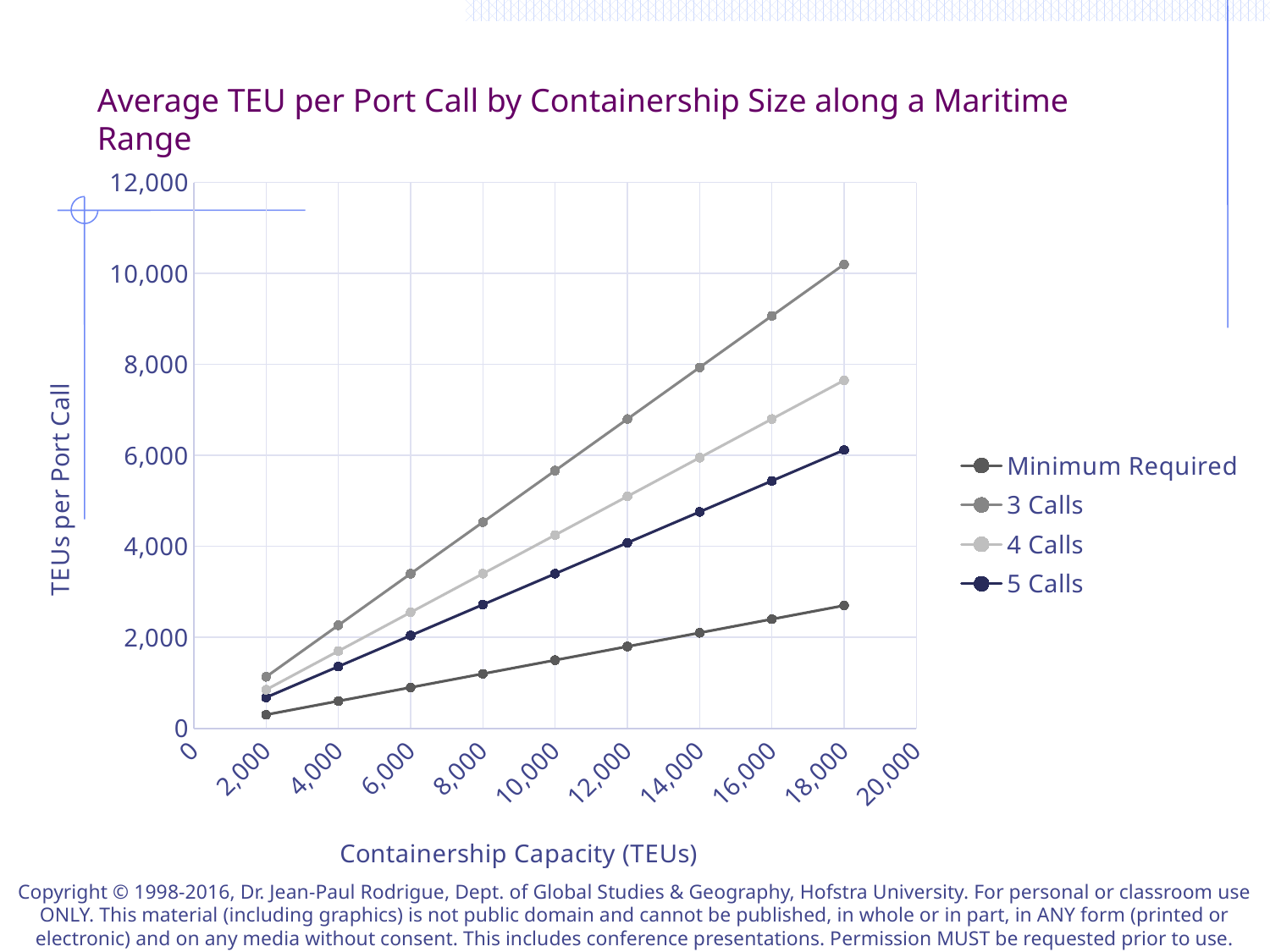
What is the label of the vertical axis? TEUs per Port Call How many data points are plotted for the 3 Calls series? 9 Which series has the highest value at a containership capacity of 18,000 TEUs? 3 Calls Which series has the lowest value at a containership capacity of 18,000 TEUs? Minimum Required Is the value for Minimum Required at 10,000 TEUs greater or less than 2,000? less Is the value for 5 Calls at 10,000 TEUs greater or less than 4,000? less How many series does the legend list? 4 Is the value for 3 Calls at 18,000 TEUs greater or less than 10,000? greater What kind of chart is shown on the slide? Line chart Do the values for the 3 Calls series rise or fall as containership capacity increases? rise At 14,000 TEUs, which is larger: the value for 4 Calls or the value for 5 Calls? 4 Calls